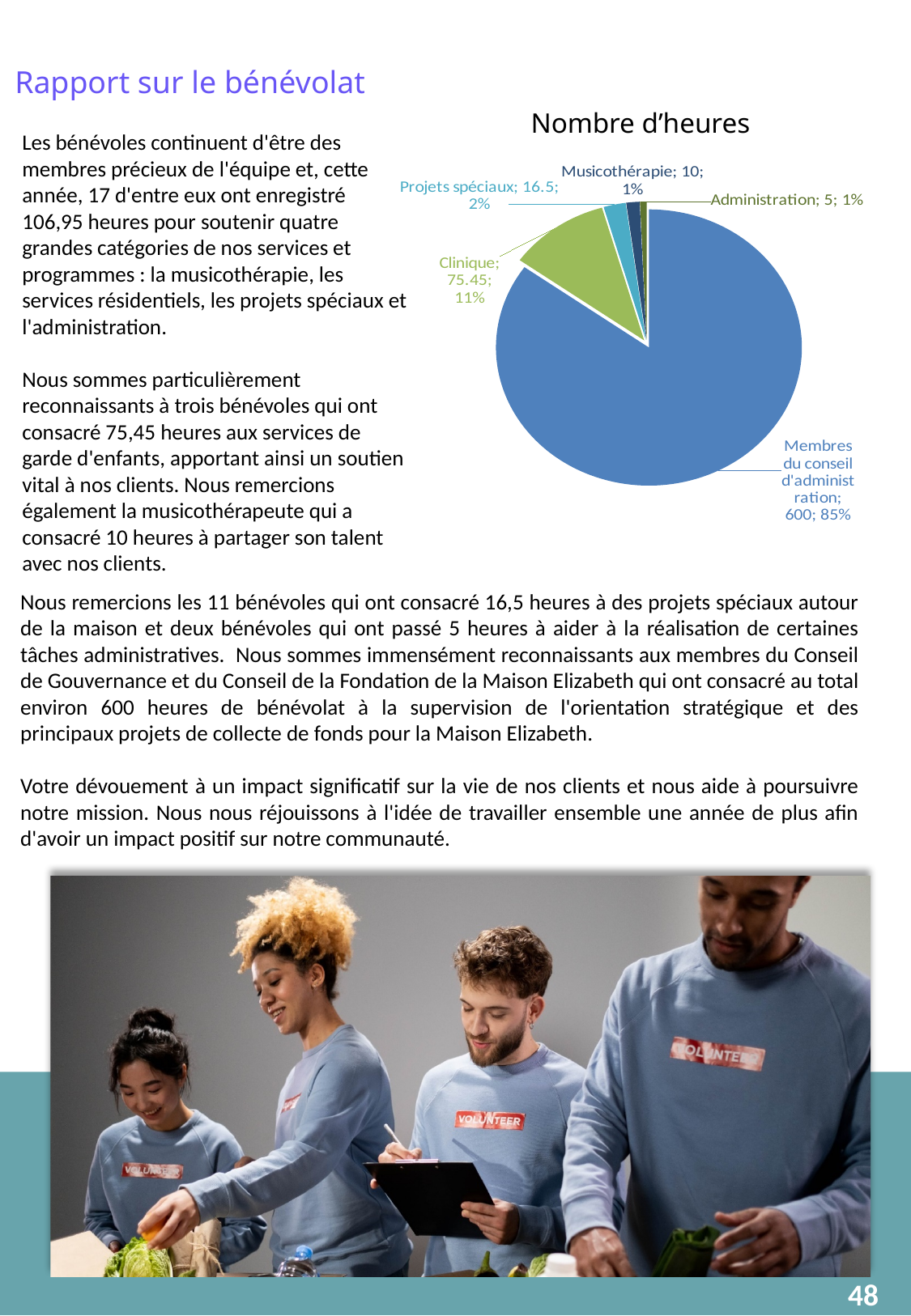
Which category has the largest slice in the "Nombre d'heures" pie chart? Membres du conseil d'administration In the "Nombre d'heures" pie chart, how many hours are shown for Clinique? 75.45 Which category has the smallest slice in the "Nombre d'heures" pie chart? Administration In the "Nombre d'heures" pie chart, how many hours are shown for Musicothérapie? 10 In the "Nombre d'heures" pie chart, what share of the pie does Membres du conseil d'administration represent? 85% In the "Nombre d'heures" pie chart, how many hours are shown for Projets spéciaux? 16.5 In the "Nombre d'heures" pie chart, which has more hours, Musicothérapie or Administration? Musicothérapie What kind of chart is shown under the title "Nombre d'heures"? pie chart In the "Nombre d'heures" pie chart, how many hours are shown for Administration? 5 How many slices does the "Nombre d'heures" pie chart have? 5 In the "Nombre d'heures" pie chart, what share of the pie does Clinique represent? 11% In the "Nombre d'heures" pie chart, what is the difference in hours between Clinique and Projets spéciaux? 58.95